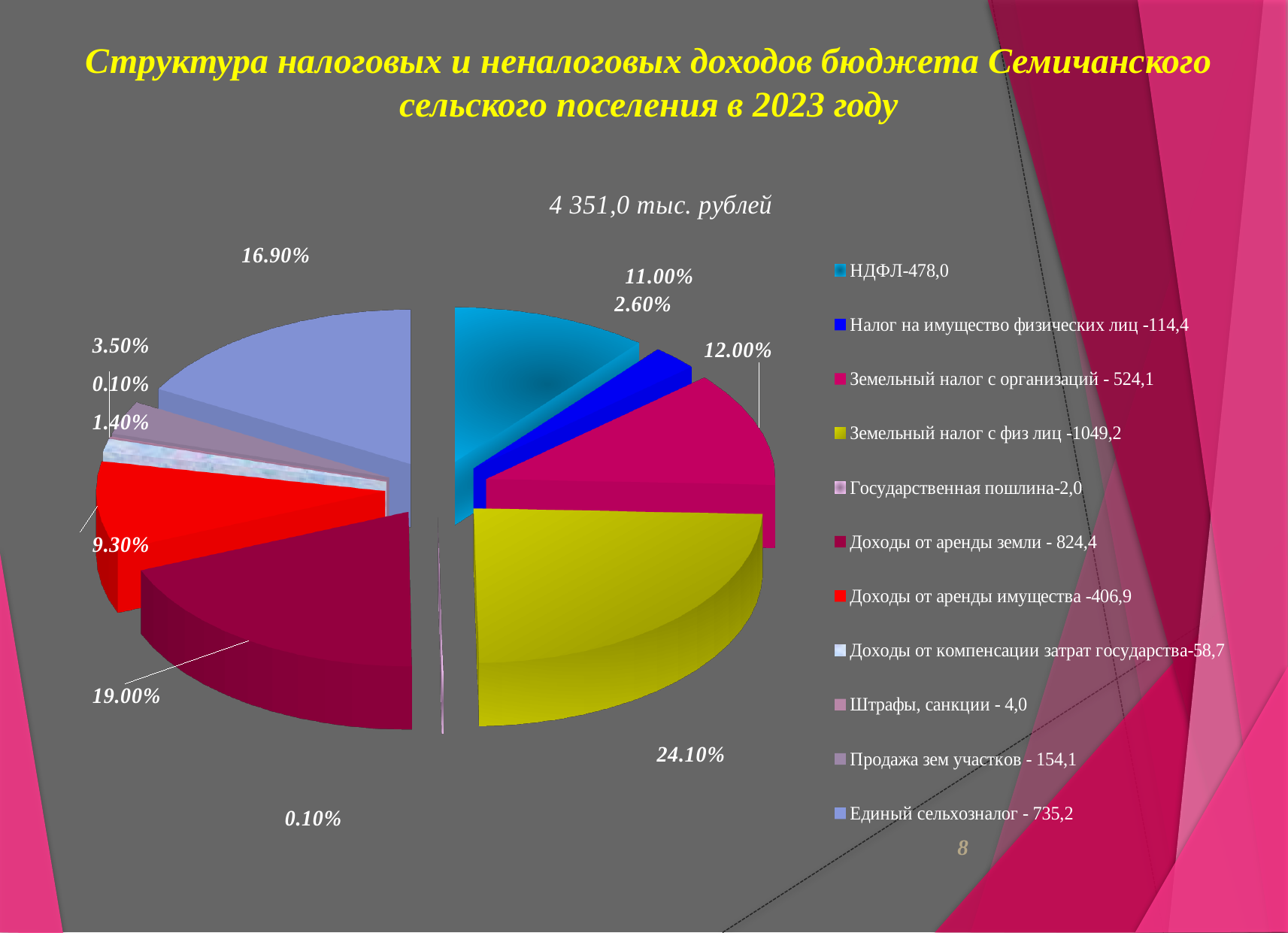
What share of the pie does the dark red slice (Доходы от аренды земли) represent? 19.00% What total amount is shown above the pie chart? 4 351,0 тыс. рублей Which category has the largest value in the legend? Земельный налог с физ лиц Which category has the smallest value in the legend? Государственная пошлина What value is shown in the legend for НДФЛ? 478,0 What value is shown in the legend for Доходы от аренды имущества? 406,9 What is the difference between the values for Земельный налог с физ лиц and Доходы от аренды земли? 224,8 What kind of chart is shown on the slide? pie chart What share of the pie does the yellow slice (Земельный налог с физ лиц) represent? 24.10% What value is shown in the legend for Земельный налог с физ лиц? 1049,2 How many categories does the legend of the pie chart list? 11 Which is larger: НДФЛ or Единый сельхозналог? Единый сельхозналог